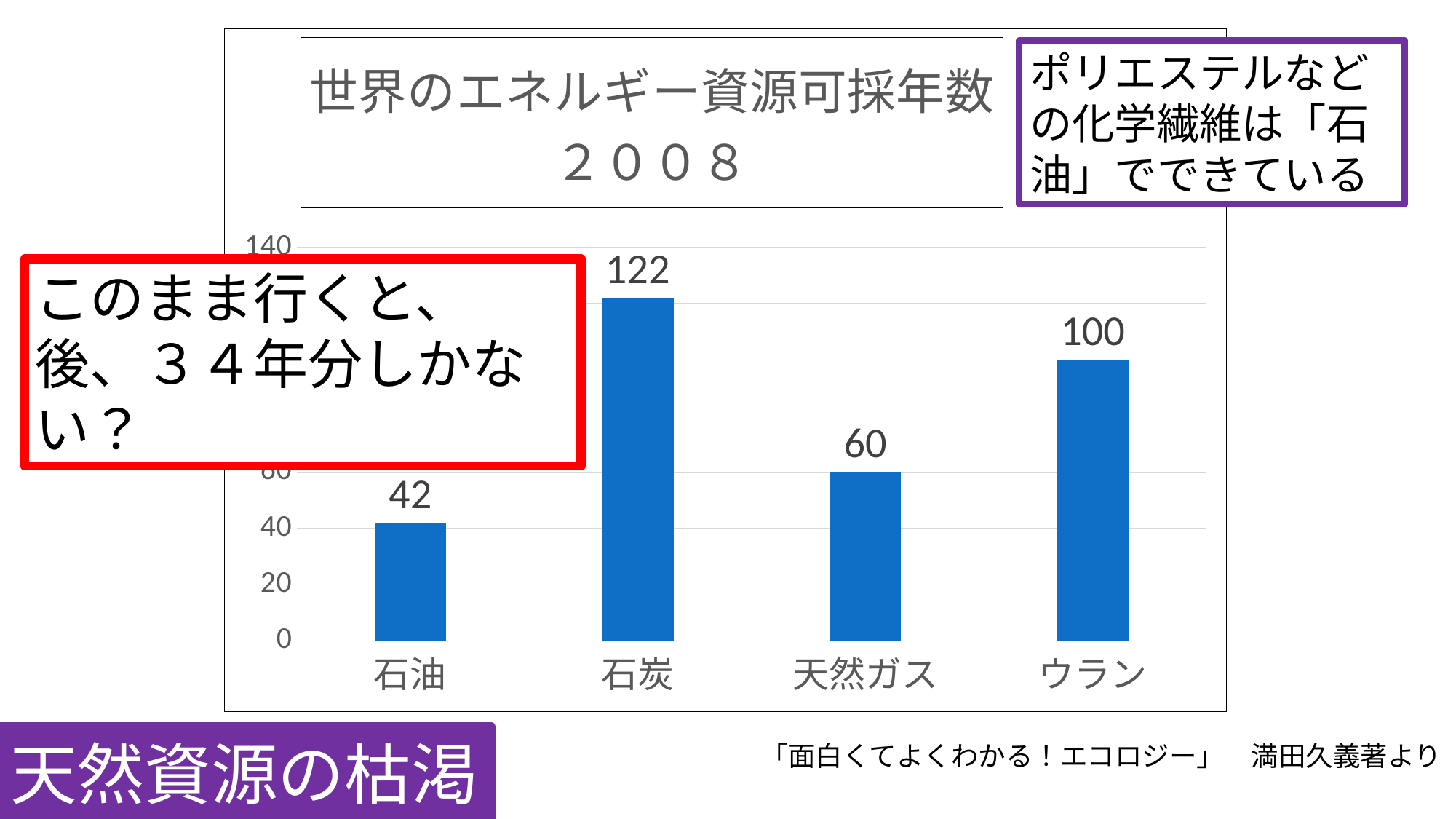
What is the value for 天然ガス (natural gas)? 60 What is the difference between the values for 石炭 and 石油? 80 Is the value for 石炭 greater or less than 100? greater What is the title of the chart? 世界のエネルギー資源可採年数 ２００８ Which category has the highest value? 石炭 What kind of chart is shown on the slide? bar chart Which is larger, the value for ウラン or the value for 天然ガス? ウラン Which category has the lowest value? 石油 How many categories are shown on the x axis? 4 What is the value for 石油 (oil)? 42 What is the value for 石炭 (coal)? 122 What is the value for ウラン (uranium)? 100